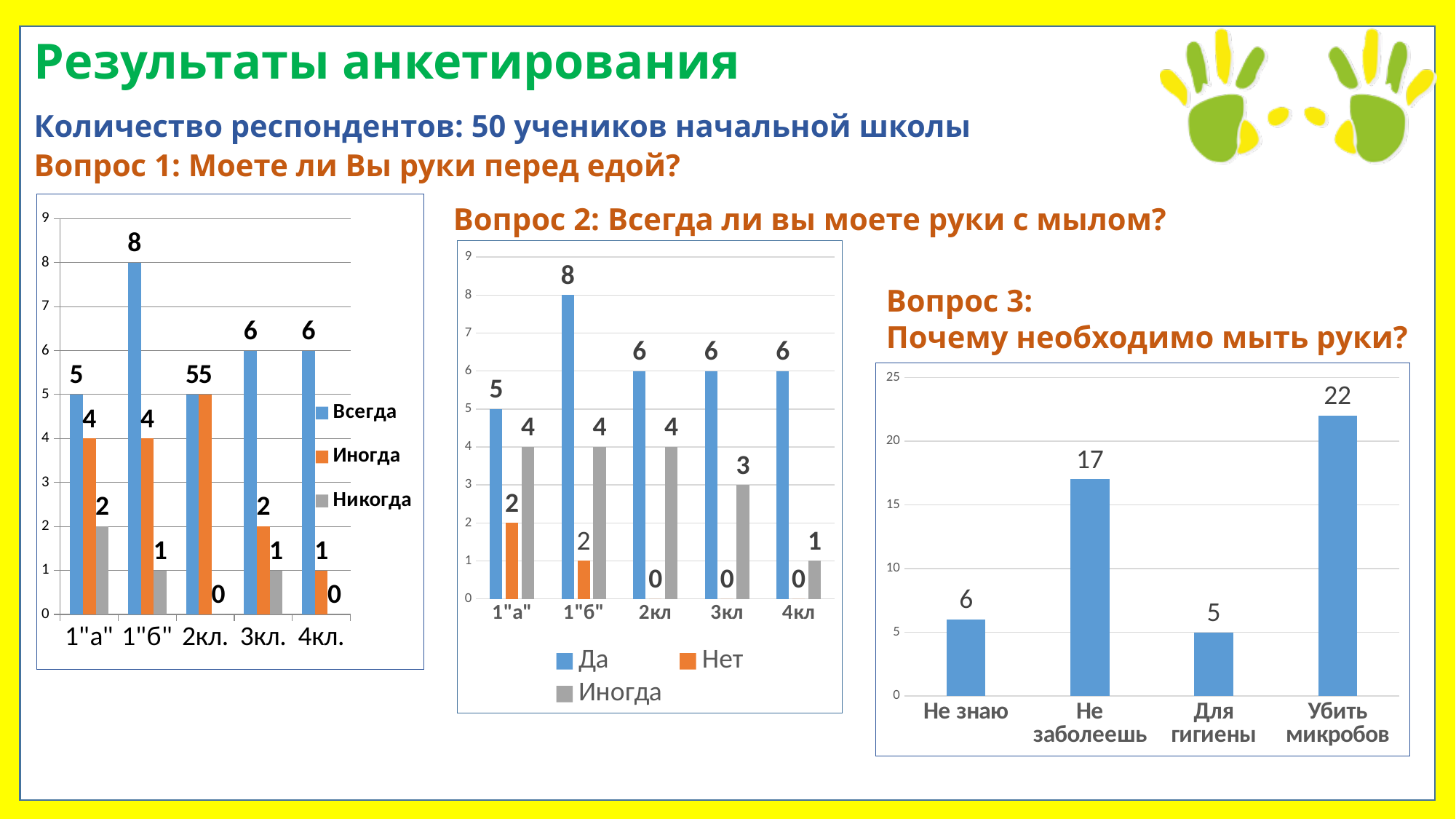
In the chart for Вопрос 3 (right), which category has the lowest value? Для гигиены In the chart for Вопрос 1 (left), what is the difference between "Всегда" and "Никогда" for 1"а"? 3 In the chart for Вопрос 2 (middle), what is the value of "Иногда" for 3кл? 3 In the chart for Вопрос 3 (right), what is the difference between "Не заболеешь" and "Не знаю"? 11 In the chart for Вопрос 2 (middle), how many series does the legend list? 3 In the chart for Вопрос 2 (middle), what is the value of "Да" for 1"б"? 8 In the chart for Вопрос 1 (left), which class has the highest value for "Всегда"? 1"б" In the chart for Вопрос 3 (right), what is the value for "Убить микробов"? 22 What type of chart is used for Вопрос 3 (right)? Bar chart In the chart for Вопрос 3 (right), how many categories are shown on the x axis? 4 In the chart for Вопрос 2 (middle), which is larger: "Нет" for 1"а" or "Иногда" for 1"а"? Иногда In the chart for Вопрос 1 (left), what is the value of "Иногда" for 2кл.? 5